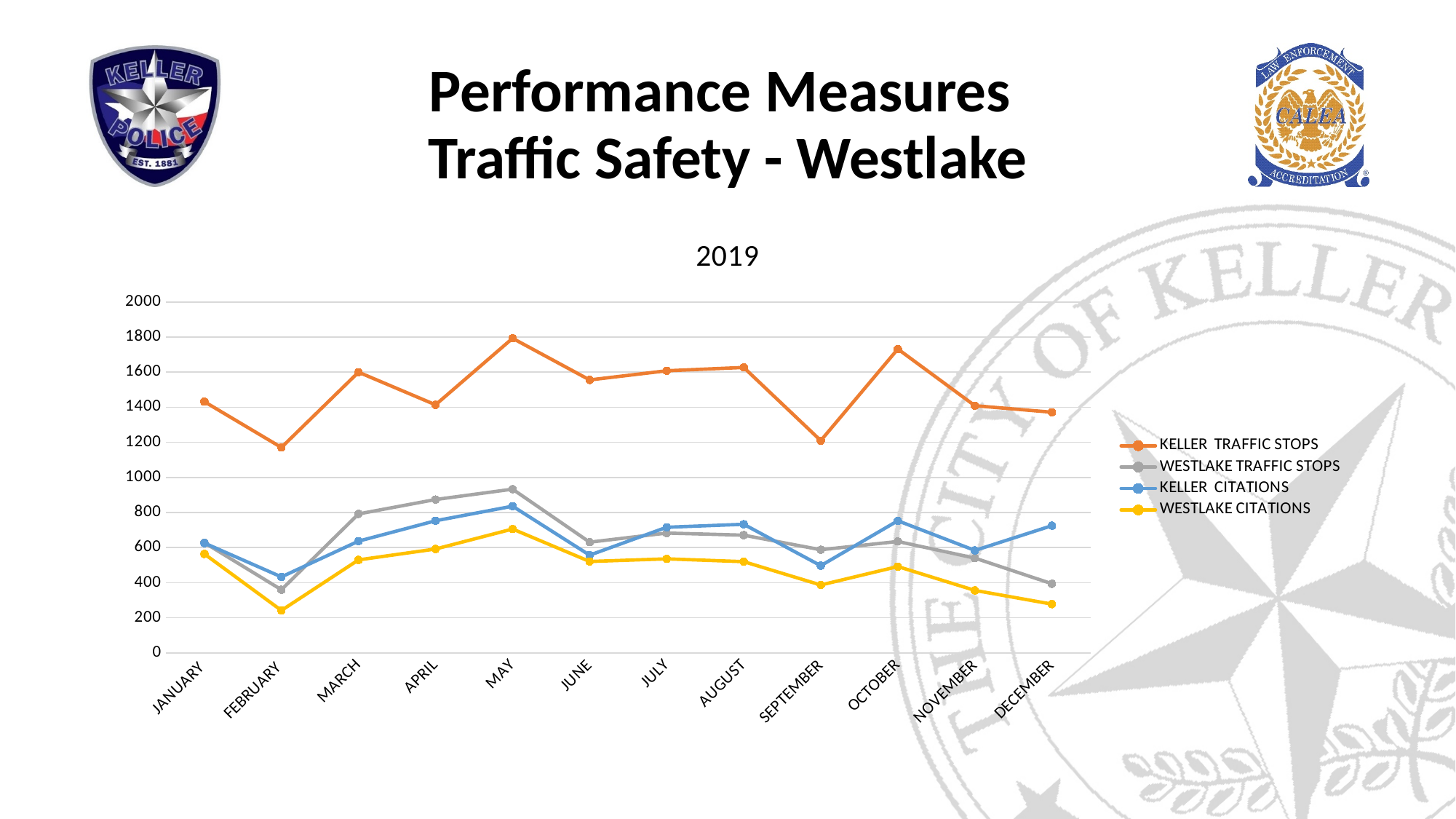
Is the value for Keller Traffic Stops in May greater or less than 1600? greater In April, which is larger: Westlake Traffic Stops or Keller Citations? Westlake Traffic Stops In which month are Keller Citations lowest? February How many months are plotted along the x axis? 12 Do Westlake Citations rise or fall from October to December? Fall In which month are Westlake Traffic Stops highest? May In which month are Keller Traffic Stops highest? May What is the title of the chart? 2019 What kind of chart is shown on the slide? Line chart How many series does the legend list? 4 Is the value for Keller Traffic Stops in February greater or less than 1200? less Is the value for Westlake Citations in February greater or less than 400? less